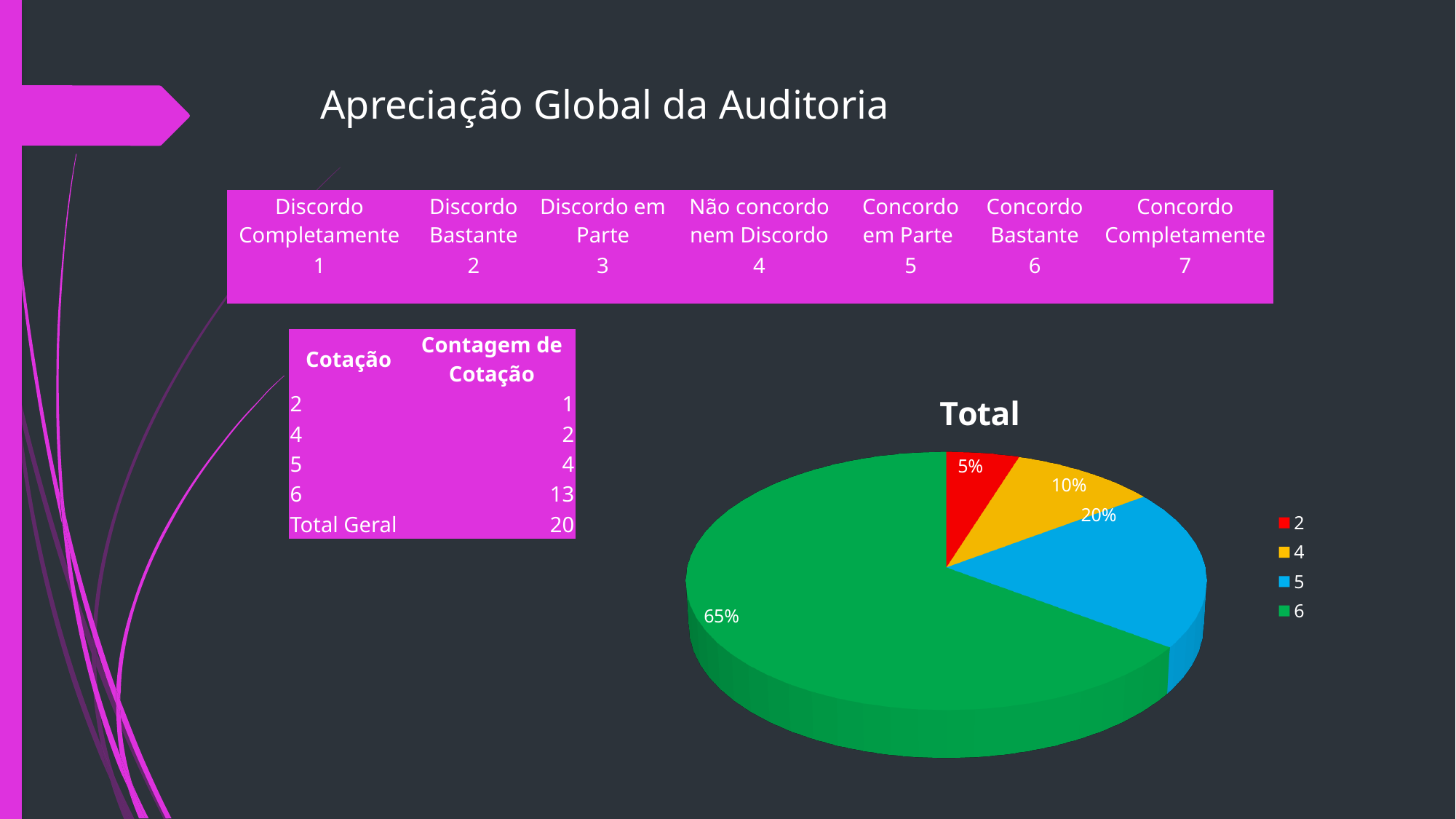
What share of the pie does category 2 have? 5% What colour is the slice for category 2? red What is the difference in percentage points between the slices for category 6 and category 5? 45% What share of the pie does category 5 have? 20% What kind of chart is shown on the slide? pie chart What share of the pie does category 6 have? 65% What is the title of the chart? Total Which slice is larger, category 4 or category 5? 5 How many categories does the legend list? 4 Which category has the largest slice of the pie? 6 What share of the pie does category 4 have? 10% Which category has the smallest slice of the pie? 2